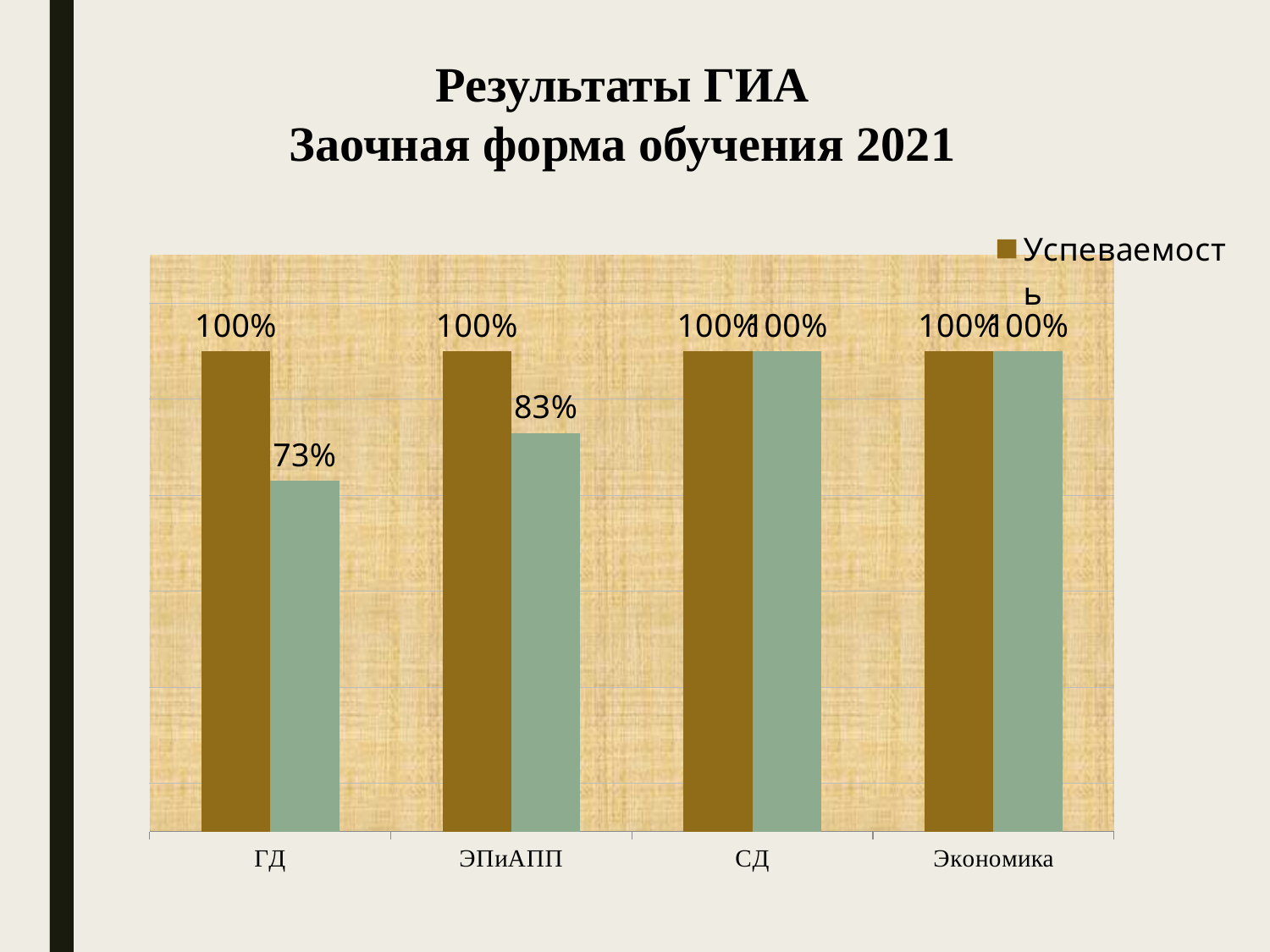
What kind of chart is shown on the slide? Bar chart How many categories are shown on the x axis? 4 What value does the green bar show for ГД? 73% What value does the green bar show for ЭПиАПП? 83% Which category has the lowest green bar? ГД What is the difference between the brown bar and the green bar for ГД? 27% What series name is shown in the legend? Успеваемость What is the Успеваемость value for ГД? 100% Which is larger: the green bar for ЭПиАПП or the green bar for ГД? ЭПиАПП What is the title of the slide? Результаты ГИА Заочная форма обучения 2021 What is the difference between the brown bar and the green bar for ЭПиАПП? 17% What value does the green bar show for СД? 100%